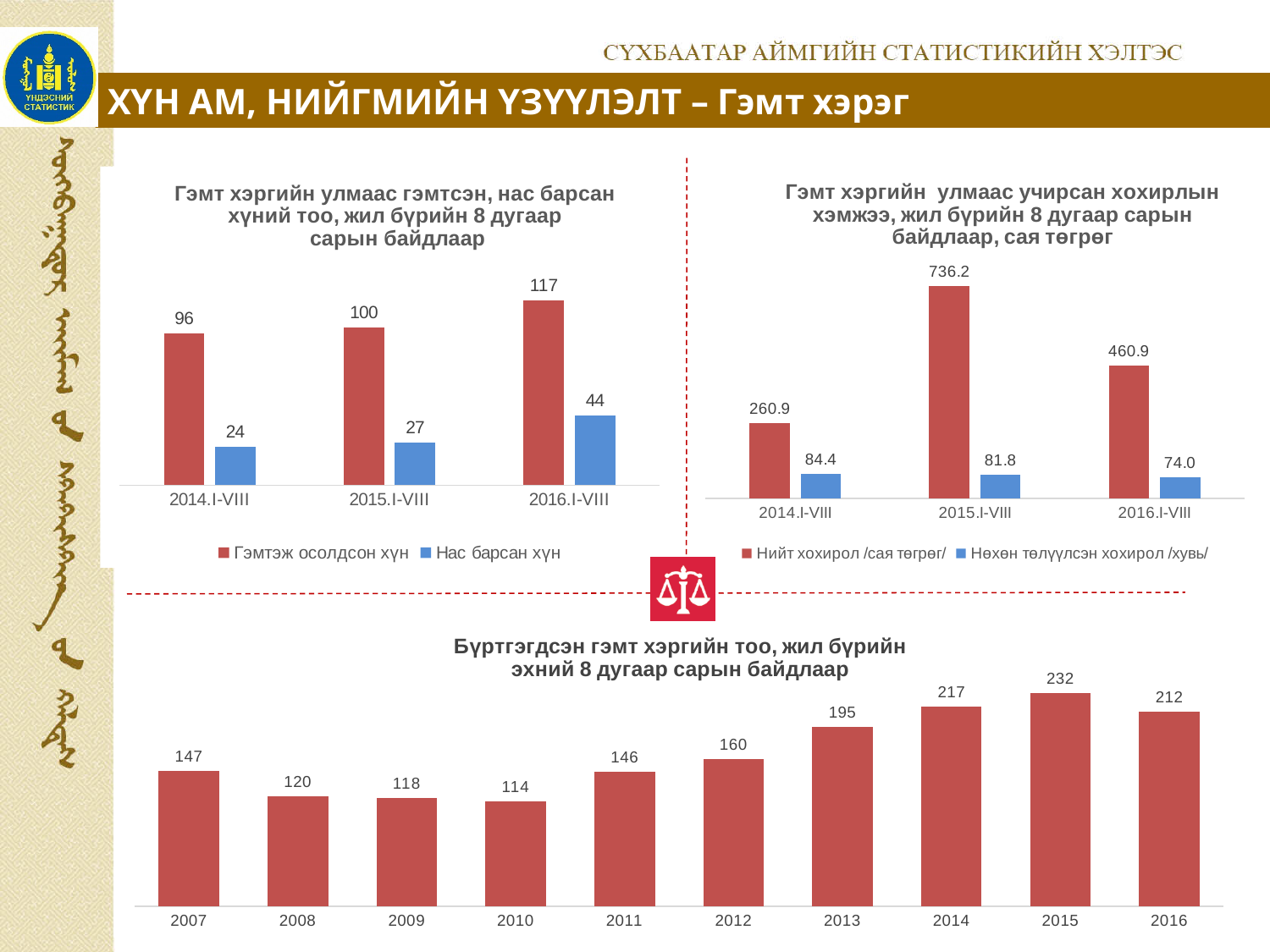
In the top-right chart (Гэмт хэргийн улмаас учирсан хохирлын хэмжээ), which period has the lowest value for Нөхөн төлүүлсэн хохирол? 2016.I-VIII In the top-right chart (Гэмт хэргийн улмаас учирсан хохирлын хэмжээ), how many series does the legend list? 2 In the top-left chart (Гэмт хэргийн улмаас гэмтсэн, нас барсан хүний тоо), what is the difference between Гэмтэж осолдсон хүн and Нас барсан хүн in 2014.I-VIII? 72 In the bottom chart (Бүртгэгдсэн гэмт хэргийн тоо), which year has the highest value? 2015 In the bottom chart (Бүртгэгдсэн гэмт хэргийн тоо), how many years are shown on the x axis? 10 In the bottom chart (Бүртгэгдсэн гэмт хэргийн тоо), what is the difference between the values for 2015 and 2016? 20 In the top-left chart (Гэмт хэргийн улмаас гэмтсэн, нас барсан хүний тоо), do the values for Гэмтэж осолдсон хүн rise or fall from 2014.I-VIII to 2016.I-VIII? rise In the top-right chart (Гэмт хэргийн улмаас учирсан хохирлын хэмжээ), what is the value for Нийт хохирол in 2015.I-VIII? 736.2 In the bottom chart (Бүртгэгдсэн гэмт хэргийн тоо), what is the value for 2013? 195 In the bottom chart (Бүртгэгдсэн гэмт хэргийн тоо), which year has the lowest value? 2010 In the top-left chart (Гэмт хэргийн улмаас гэмтсэн, нас барсан хүний тоо), what is the value for Нас барсан хүн in 2016.I-VIII? 44 What kind of chart is the bottom chart (Бүртгэгдсэн гэмт хэргийн тоо)? bar chart